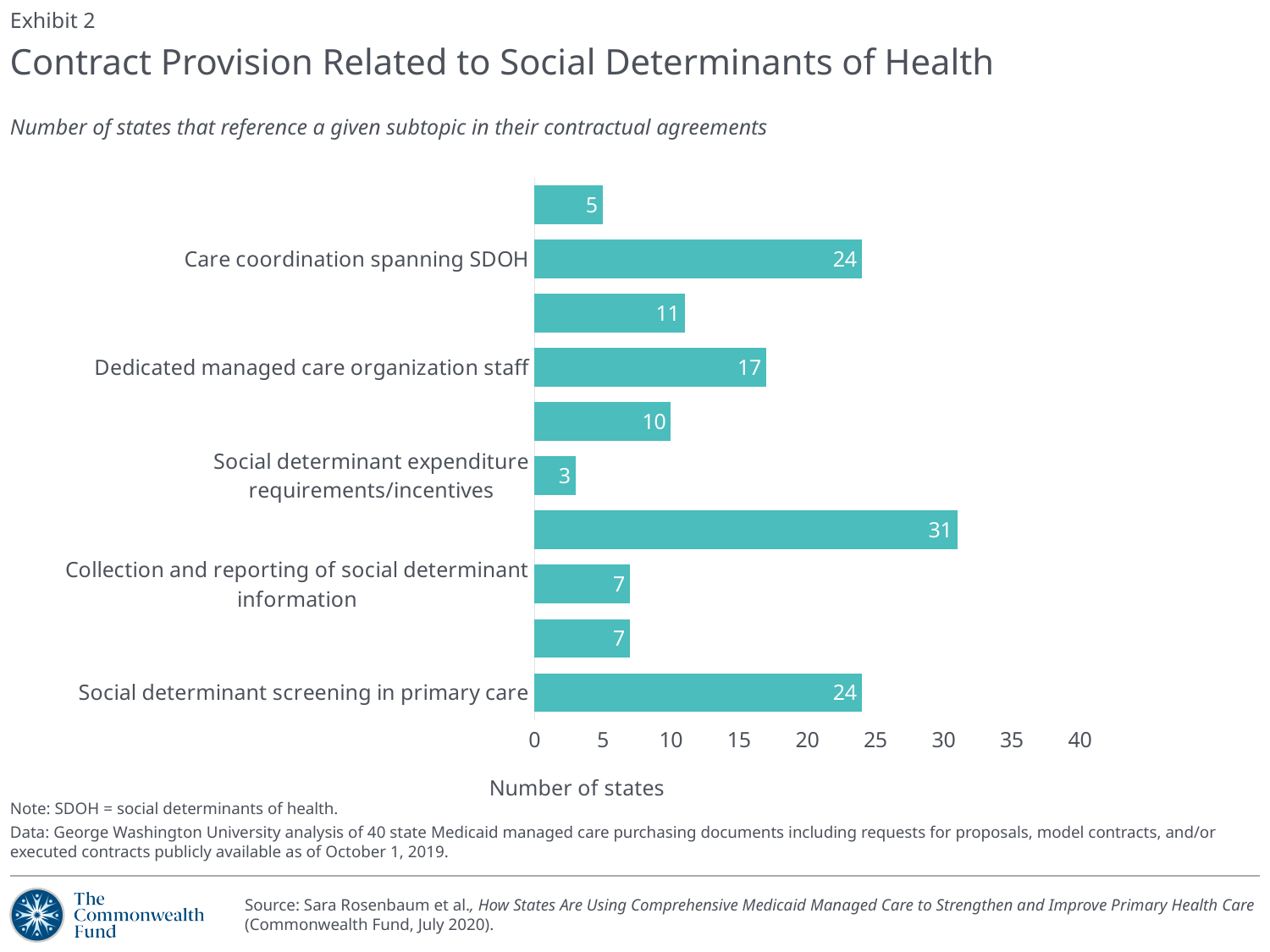
What is the value for social determinant expenditure requirements/incentives? 3 What kind of chart is shown on the slide? bar chart What is the value for dedicated managed care organization staff? 17 Is the value for social determinant screening in primary care greater or less than 20? greater How many bars are plotted in the chart? 10 How many states reference care coordination spanning SDOH in their contracts? 24 Which labeled category has the lowest number of states? Social determinant expenditure requirements/incentives Which is larger: the value for dedicated managed care organization staff or the value for collection and reporting of social determinant information? Dedicated managed care organization staff What is the title of the horizontal axis? Number of states What is the difference between the values for care coordination spanning SDOH and dedicated managed care organization staff? 7 How many states reference collection and reporting of social determinant information? 7 What is the value for social determinant screening in primary care? 24